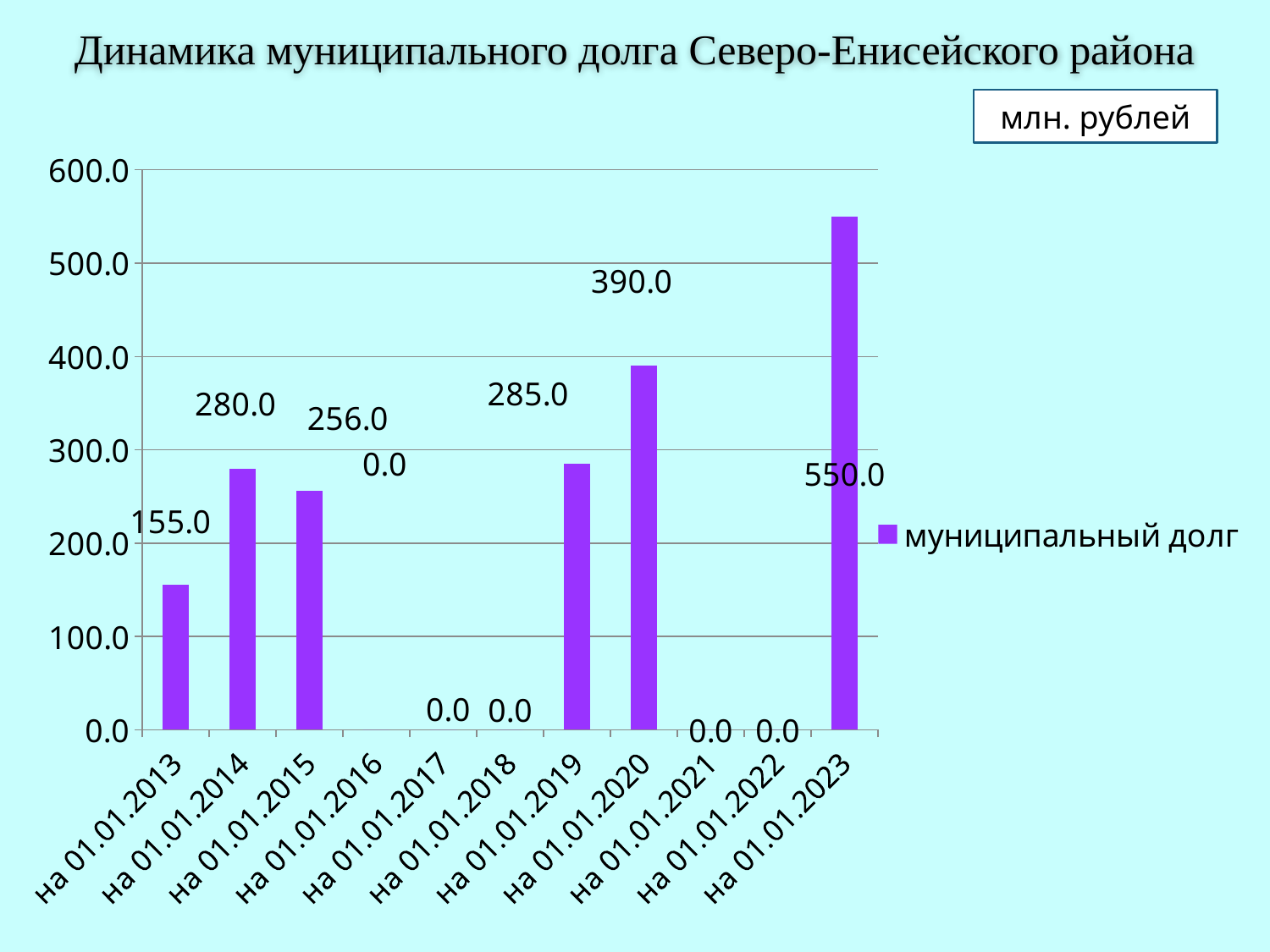
Which is larger, the municipal debt on 01.01.2014 or on 01.01.2019? на 01.01.2014 What unit of measurement is indicated on the slide? млн. рублей What kind of chart is shown on the slide? bar chart What is the difference between the municipal debt on 01.01.2014 and on 01.01.2013? 125.0 How many dates have a municipal debt of 0.0? 5 Is the municipal debt on 01.01.2023 greater or less than 500.0? greater What is the difference between the municipal debt on 01.01.2023 and on 01.01.2020? 160.0 What is the municipal debt value for на 01.01.2013? 155.0 Which date has the highest municipal debt? на 01.01.2023 What is the municipal debt value for на 01.01.2015? 256.0 How many dates are shown on the x axis? 11 What is the municipal debt value for на 01.01.2020? 390.0